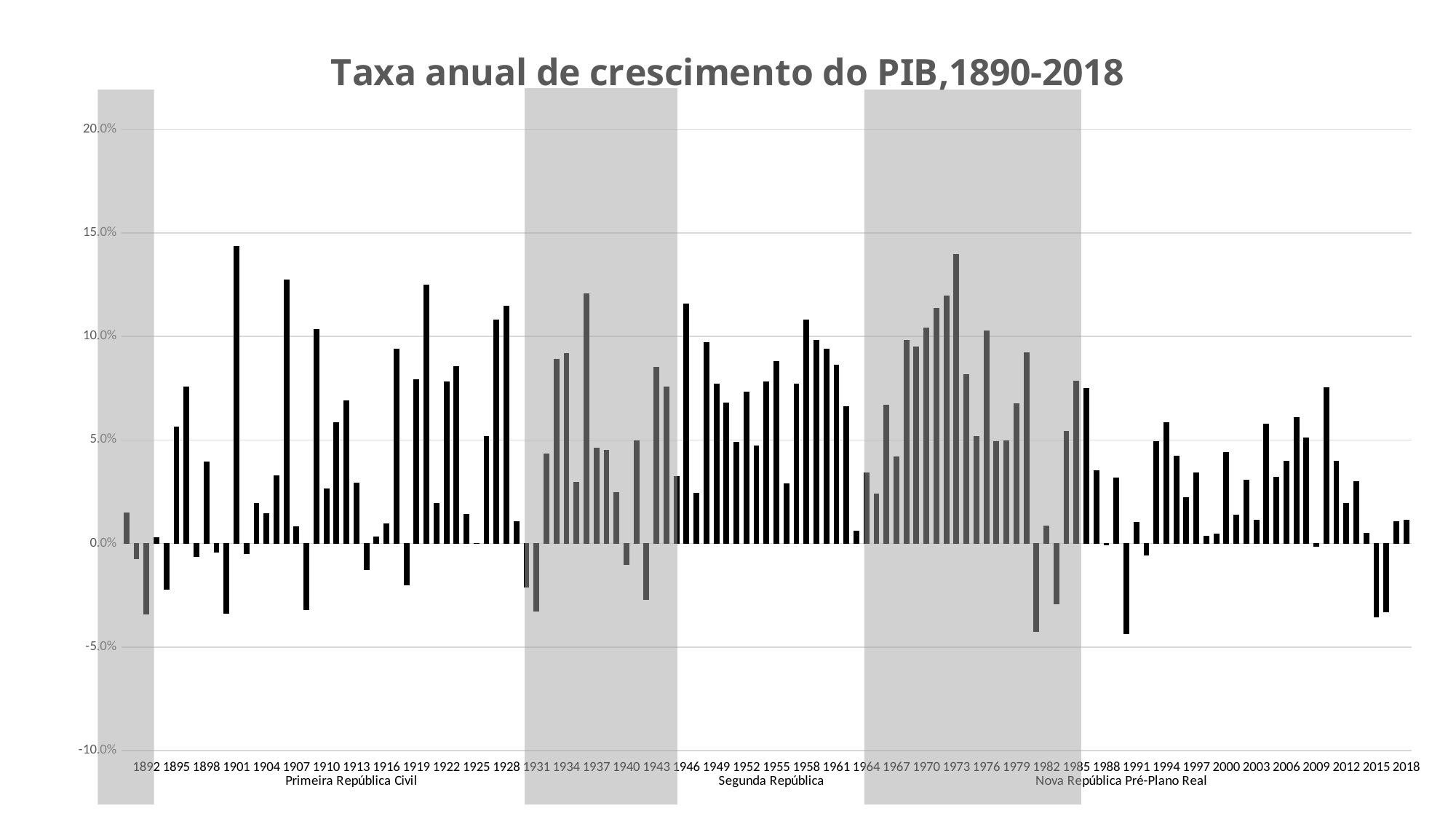
Is the value for 1892 greater or less than 0.0%? less What kind of chart is shown on the slide? bar chart Which year has the larger value, 1901 or 1892? 1901 Which year has the larger value, 1907 or 1910? 1910 Is the value for 1907 greater or less than 10.0%? less Is the value for 2015 greater or less than 0.0%? less What is the title of the chart? Taxa anual de crescimento do PIB,1890-2018